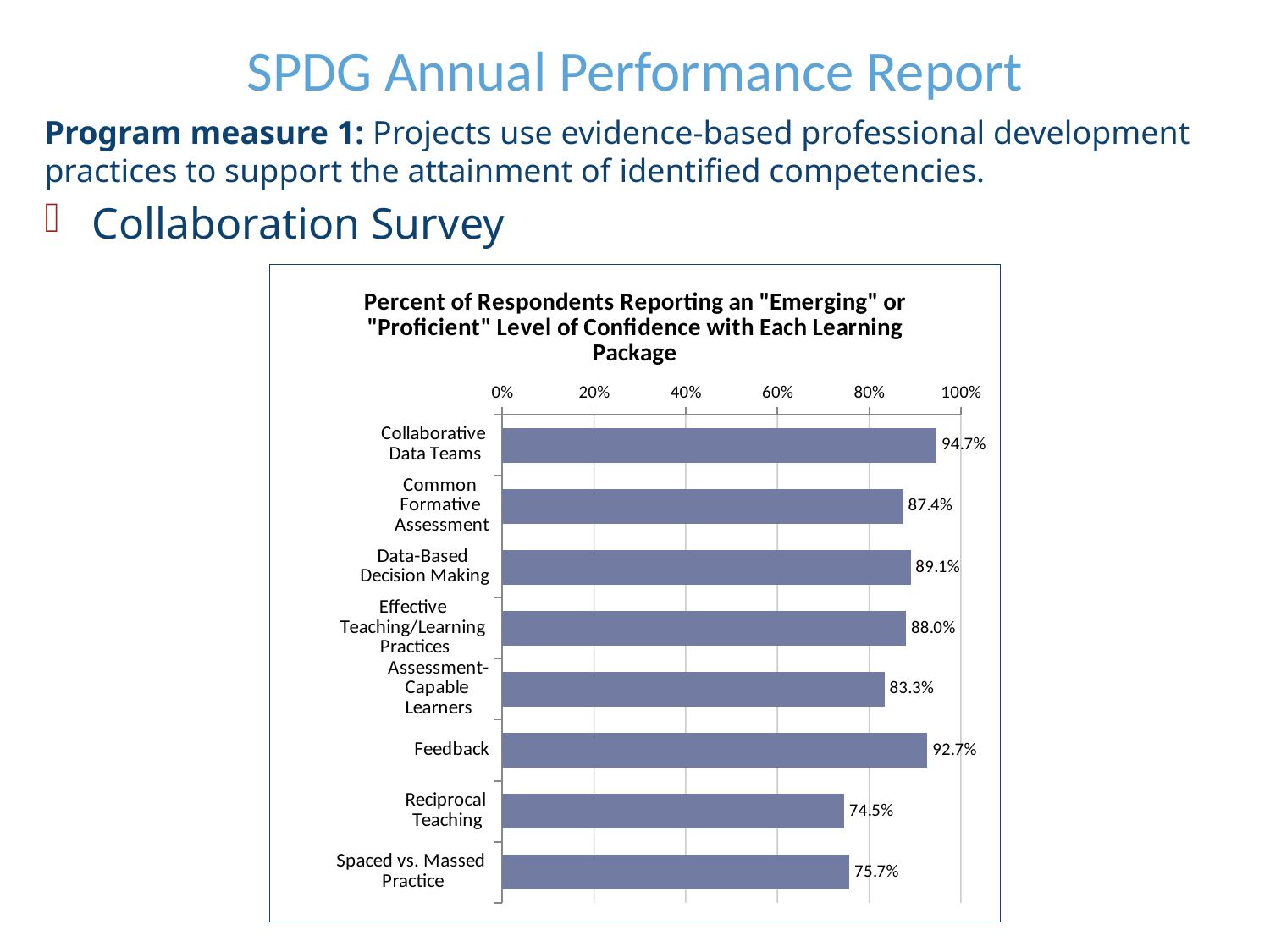
How many learning packages are shown in the chart? 8 What is the difference between the values for Collaborative Data Teams and Reciprocal Teaching? 20.2% What is the value shown for Assessment-Capable Learners? 83.3% Is the value for Feedback greater or less than 80%? greater Which learning package has the lowest percent of respondents reporting an "Emerging" or "Proficient" level of confidence? Reciprocal Teaching What is the difference between the values for Feedback and Spaced vs. Massed Practice? 17.0% Which has a higher value, Data-Based Decision Making or Common Formative Assessment? Data-Based Decision Making What is the title of the chart? Percent of Respondents Reporting an "Emerging" or "Proficient" Level of Confidence with Each Learning Package Which learning package has the highest percent of respondents reporting an "Emerging" or "Proficient" level of confidence? Collaborative Data Teams What is the value shown for Reciprocal Teaching? 74.5% What kind of chart is shown on the slide? Bar chart What percent of respondents reported an "Emerging" or "Proficient" level of confidence with Collaborative Data Teams? 94.7%